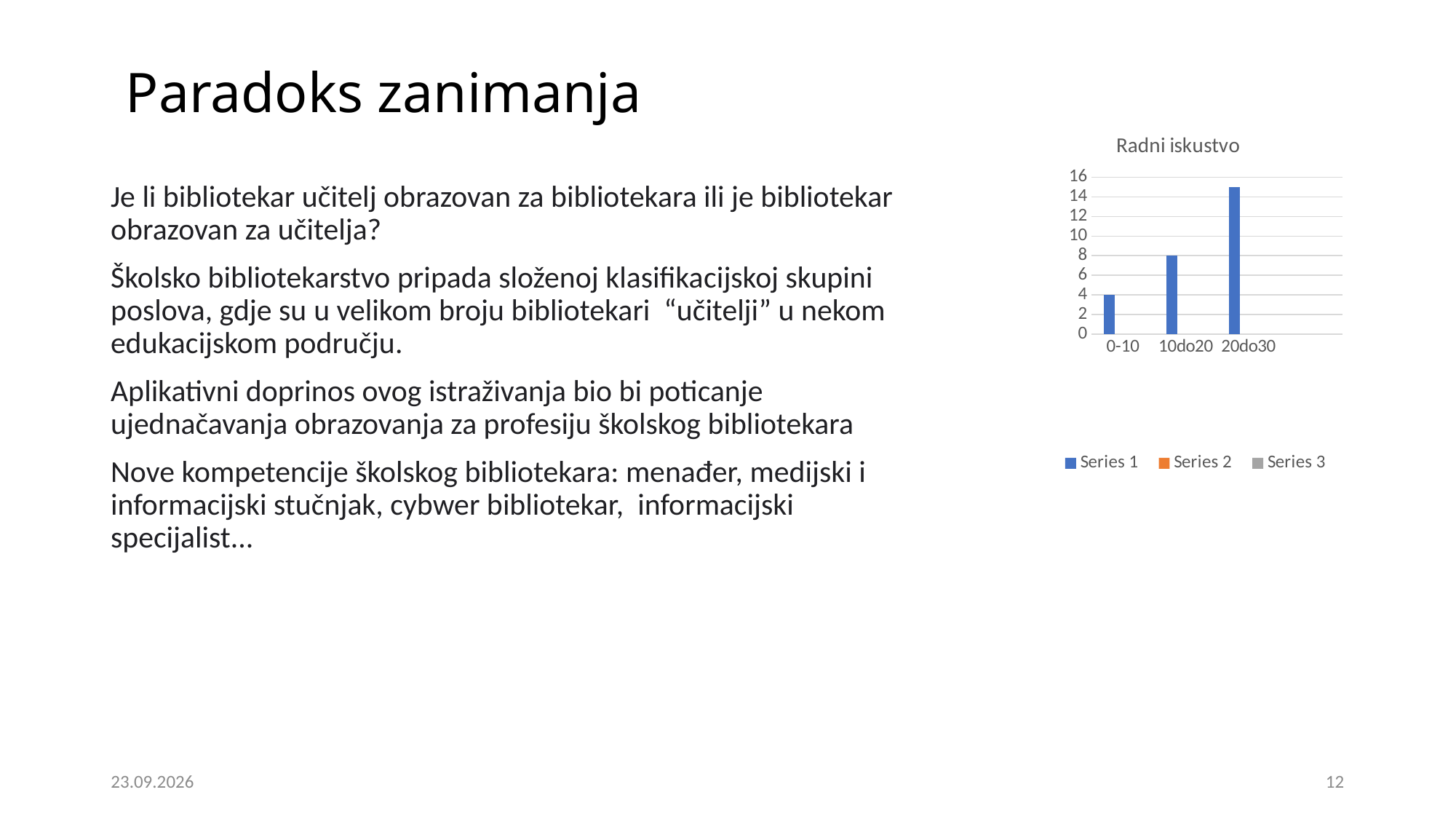
What is the value for the 0-10 category? 4 Is the value for 20do30 greater or less than 14? greater Which is larger, the value for 10do20 or the value for 20do30? 20do30 What is the title of the chart? Radni iskustvo What is the value for the 10do20 category? 8 Do the values rise or fall from left to right along the x axis? rise Which category has the highest value in the chart? 20do30 Is the value for 0-10 greater or less than 6? less Which category has the lowest value in the chart? 0-10 How many series does the chart legend list? 3 How many categories are shown on the x axis of the chart? 3 What type of chart is shown on the slide? bar chart